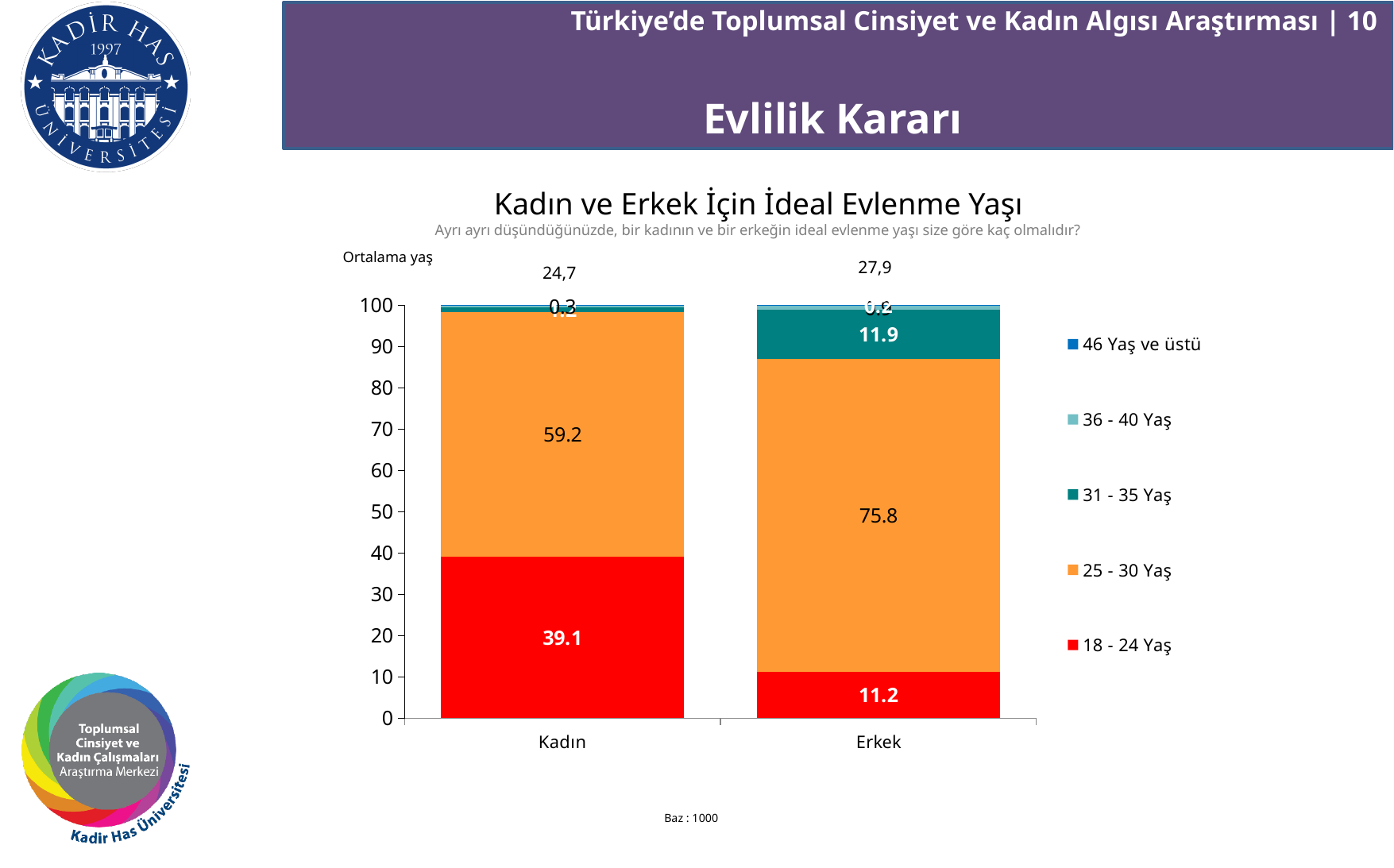
What is the average age (Ortalama yaş) shown above the Erkek bar? 27,9 How many categories are shown on the x axis? 2 What is the value of the 25 - 30 Yaş segment for Kadın? 59.2 What is the value of the 18 - 24 Yaş segment for Erkek? 11.2 What is the value of the 31 - 35 Yaş segment for Erkek? 11.9 What is the value of the 18 - 24 Yaş segment for Kadın? 39.1 What is the average age (Ortalama yaş) shown above the Kadın bar? 24,7 What is the value of the 25 - 30 Yaş segment for Erkek? 75.8 What is the difference between the 25 - 30 Yaş values for Erkek and Kadın? 16.6 Which category has the larger 18 - 24 Yaş value, Kadın or Erkek? Kadın How many series does the legend list? 5 What kind of chart is shown on the slide? Stacked bar chart